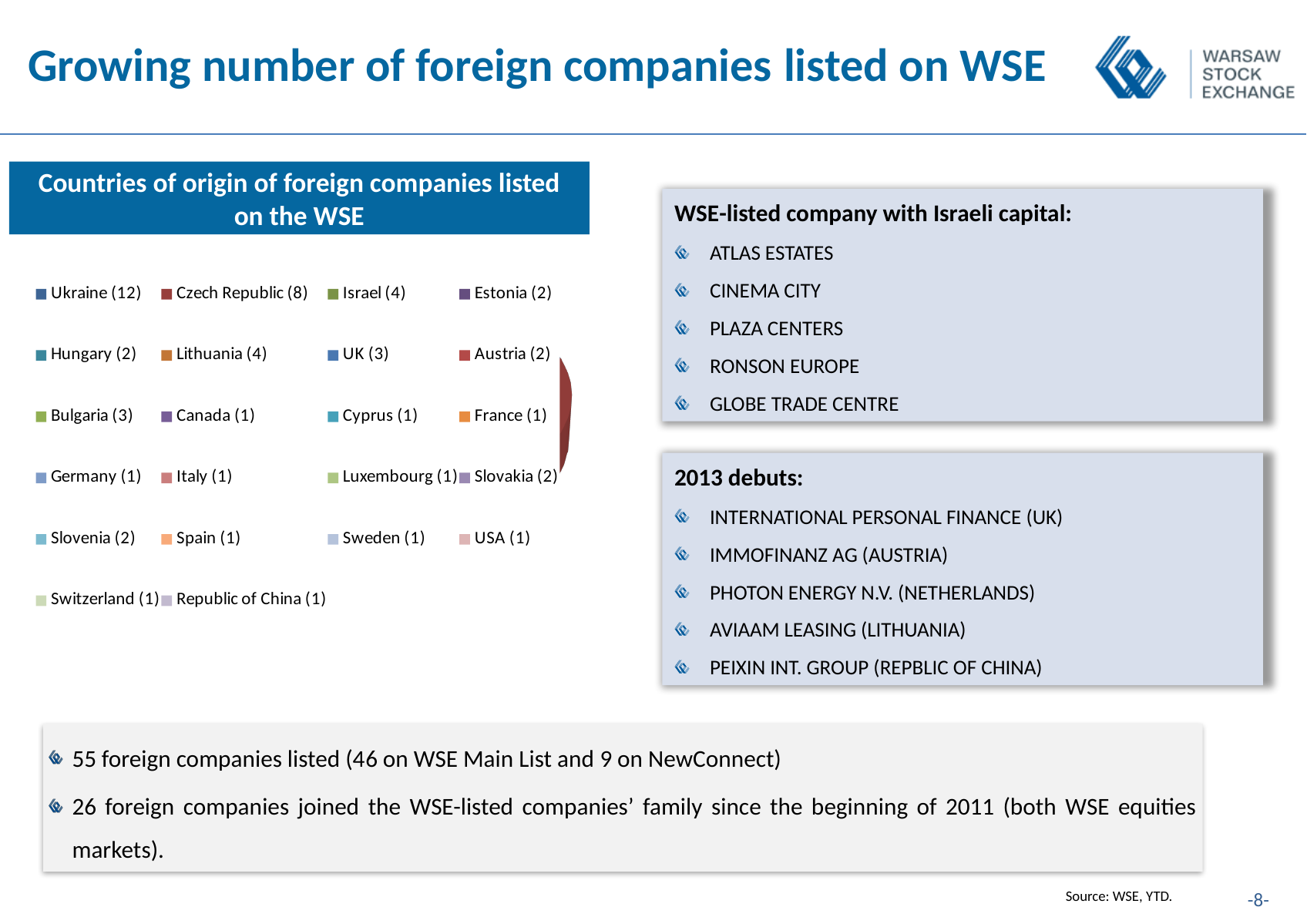
In the chart 'Countries of origin of foreign companies listed on the WSE', what is the difference between the number of companies from Ukraine and from the Czech Republic? 4 How many countries are listed in the legend of the chart 'Countries of origin of foreign companies listed on the WSE'? 22 What is the title of the chart on the left side of the slide? Countries of origin of foreign companies listed on the WSE In the chart 'Countries of origin of foreign companies listed on the WSE', how many companies come from Slovakia? 2 In the chart 'Countries of origin of foreign companies listed on the WSE', how many companies come from Ukraine? 12 In the chart 'Countries of origin of foreign companies listed on the WSE', which has more companies, the Czech Republic or Lithuania? Czech Republic In the chart 'Countries of origin of foreign companies listed on the WSE', what is the difference between the number of companies from Lithuania and from Hungary? 2 In the chart 'Countries of origin of foreign companies listed on the WSE', how many companies come from the Czech Republic? 8 In the chart 'Countries of origin of foreign companies listed on the WSE', how many companies come from the UK? 3 In the chart 'Countries of origin of foreign companies listed on the WSE', which has more companies, Israel or Bulgaria? Israel In the chart 'Countries of origin of foreign companies listed on the WSE', which country has the highest number of companies? Ukraine In the chart 'Countries of origin of foreign companies listed on the WSE', how many companies come from Israel? 4